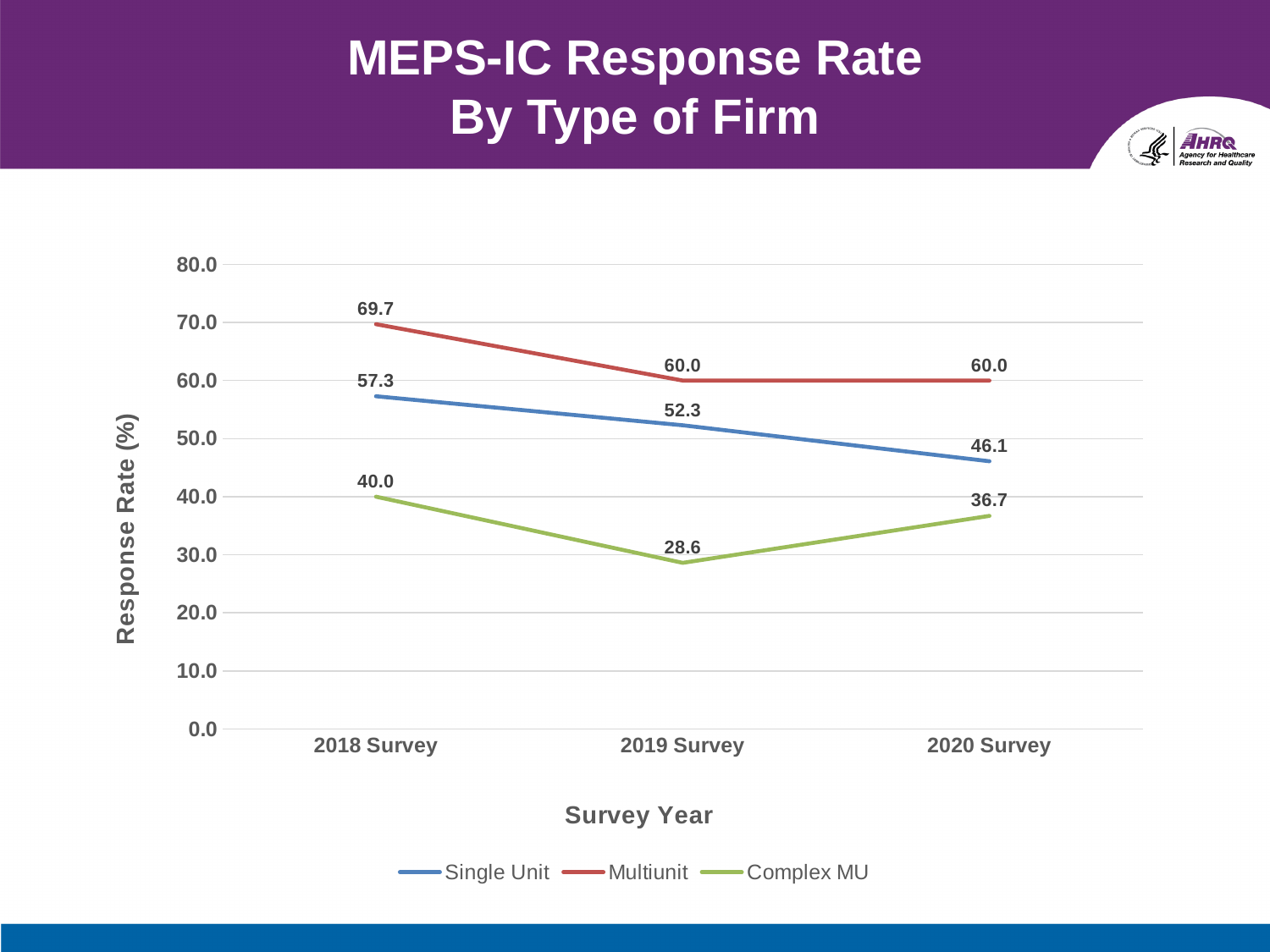
How many survey years are shown on the x axis? 3 What is the response rate for Complex MU firms in the 2020 Survey? 36.7 What is the label of the y axis? Response Rate (%) How many series does the legend list? 3 Does the Single Unit response rate rise or fall from the 2018 Survey to the 2020 Survey? Fall What is the response rate for Multiunit firms in the 2018 Survey? 69.7 What is the difference between the Multiunit and Single Unit response rates in the 2020 Survey? 13.9 What is the response rate for Single Unit firms in the 2019 Survey? 52.3 Which series has the higher response rate in the 2018 Survey, Single Unit or Complex MU? Single Unit Which survey year has the highest response rate for Single Unit firms? 2018 Survey What kind of chart is shown on the slide? Line chart Which survey year has the lowest response rate for Complex MU firms? 2019 Survey